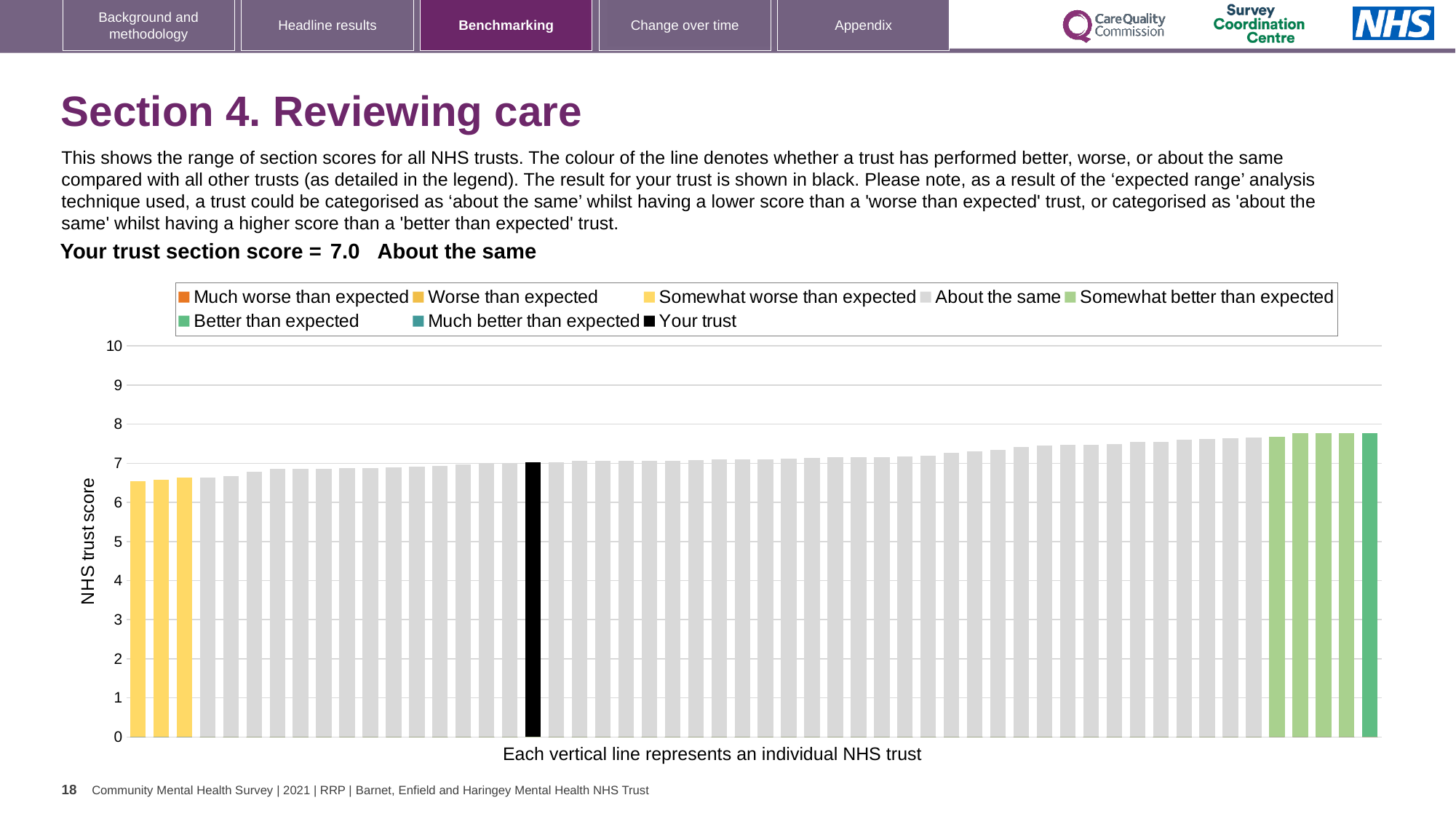
Is the value of the leftmost bar greater or less than 6? greater How many entries does the chart legend list? 8 Is the value of the black bar for your trust greater or less than 5? greater What is the section score for your trust shown on the slide? 7.0 Is the bar for your trust higher or lower than the leftmost bar? higher Do the bar values rise or fall from left to right along the x axis? rise Which category is your trust placed in for this section? About the same Is the value of the rightmost bar greater or less than 8? less What kind of chart is shown on the slide? bar chart What colour is the bar representing your trust? black What is the label on the vertical axis? NHS trust score